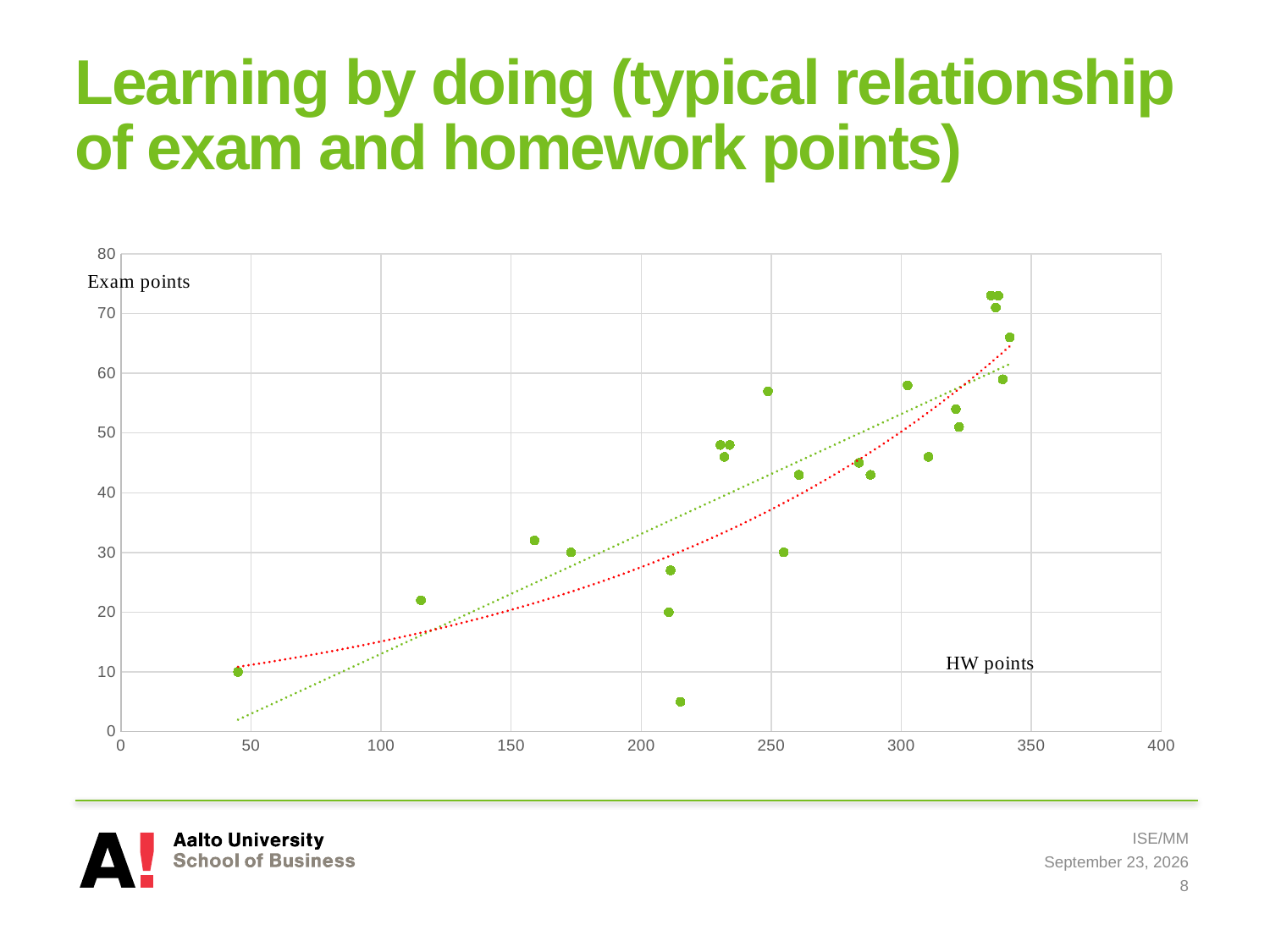
Is the lowest exam points value plotted greater or less than 10? less Is the exam points value for the point at roughly 115 HW points greater or less than 30? less What kind of chart is shown on the slide? scatter chart What label is given to the vertical axis of the chart? Exam points What label is given to the horizontal axis of the chart? HW points Is the exam points value for the student with the lowest HW points (around 45) greater or less than 20? less Do exam points generally rise or fall as HW points increase? rise What is the maximum value shown on the horizontal (HW points) axis? 400